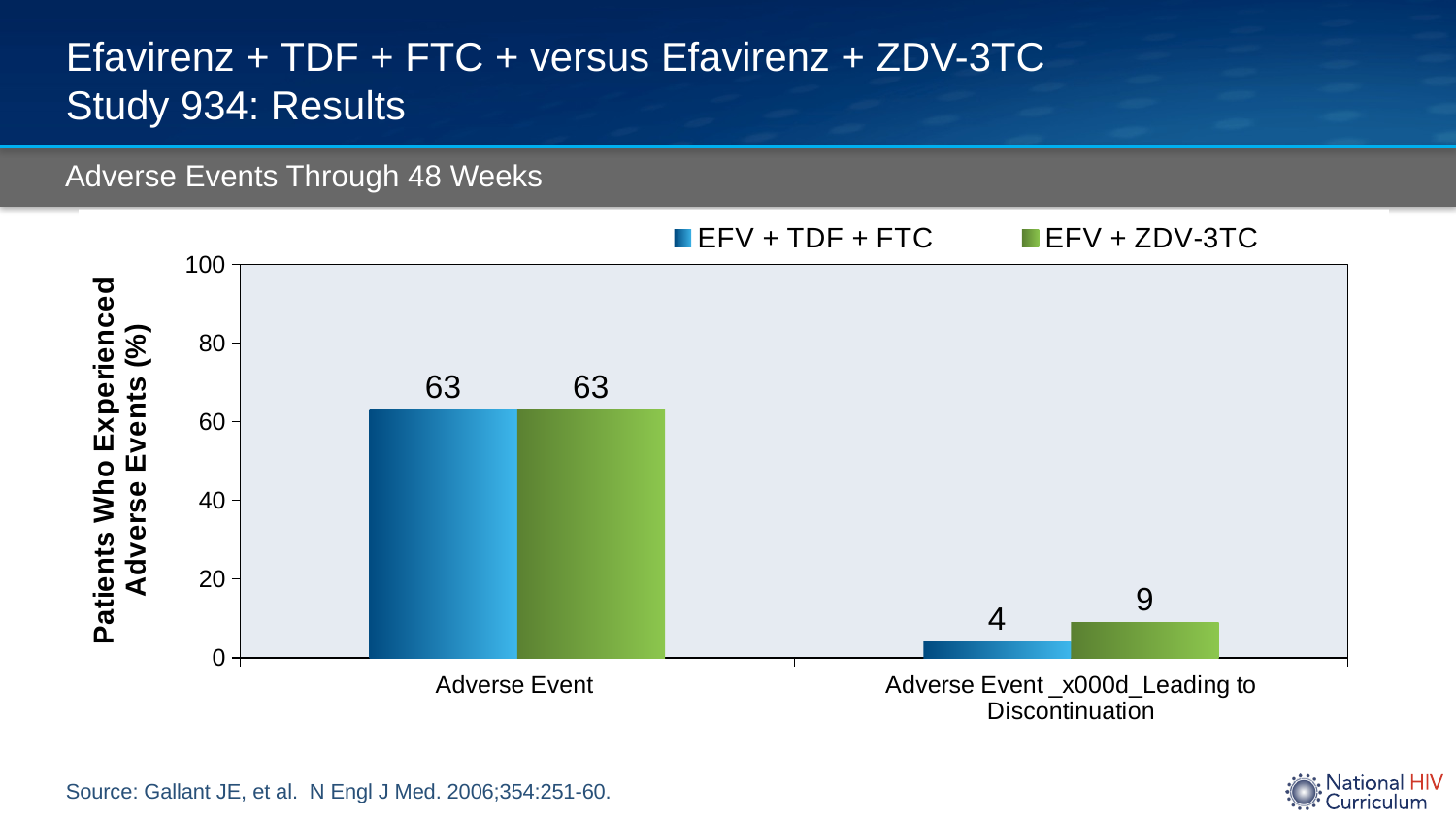
What is the difference between the two groups for adverse events leading to discontinuation? 5 How many series does the legend list? 2 Do the values for EFV + TDF + FTC rise or fall from the first category to the second? Fall How many categories are shown on the x axis? 2 What percentage of patients in the EFV + TDF + FTC group experienced an adverse event? 63 What percentage of patients in the EFV + ZDV-3TC group had an adverse event leading to discontinuation? 9 Which colour represents the EFV + ZDV-3TC series? Green What is the label of the y axis? Patients Who Experienced Adverse Events (%) What kind of chart is shown on the slide? Bar chart Which group had the higher percentage of adverse events leading to discontinuation? EFV + ZDV-3TC What is the value for EFV + TDF + FTC in the 'Adverse Event Leading to Discontinuation' category? 4 Is the value for EFV + ZDV-3TC in the 'Adverse Event' category greater or less than 40? greater